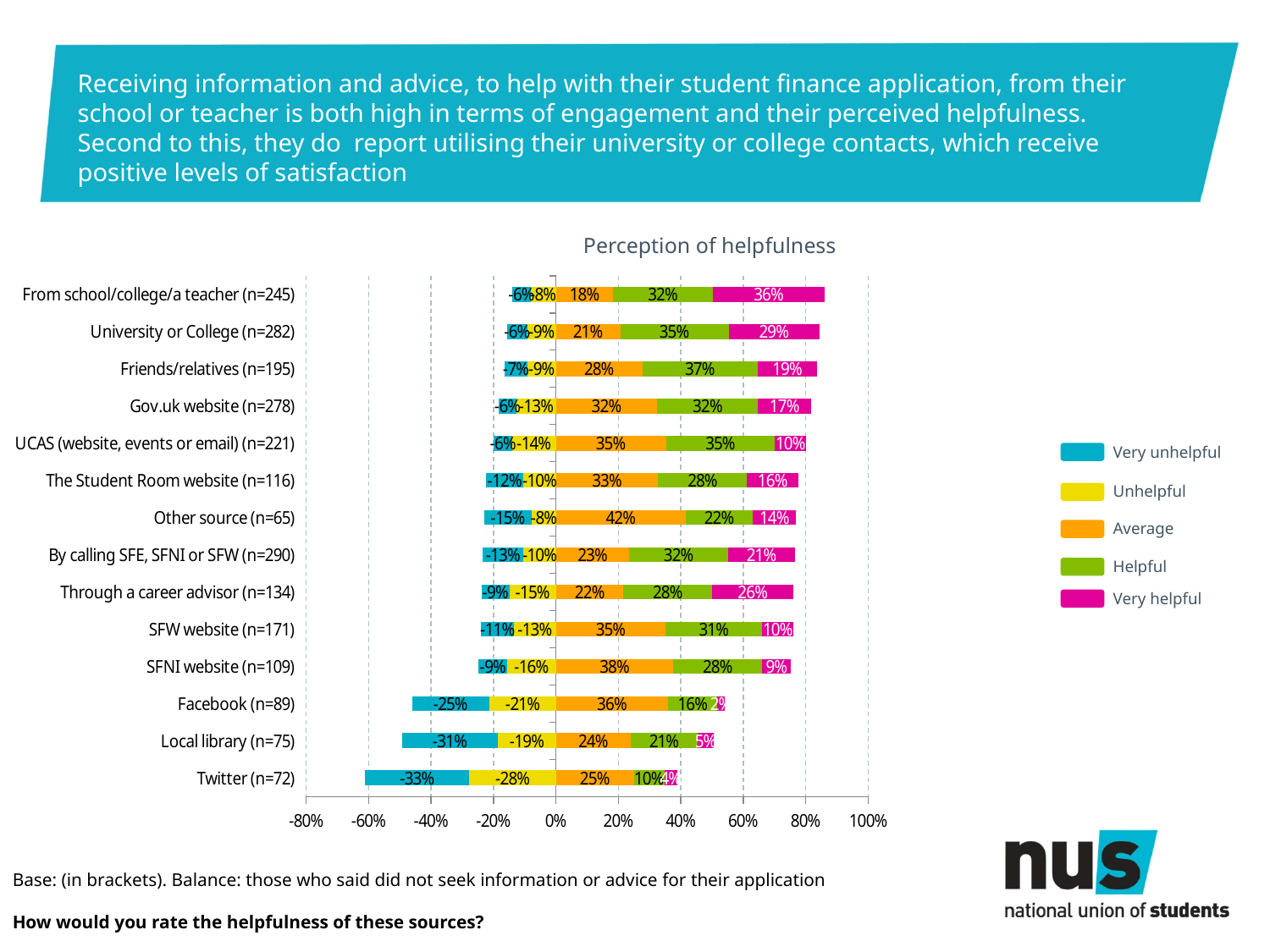
Which has a larger 'Average' value: SFNI website (n=109) or Facebook (n=89)? SFNI website (n=109) What is the title of the chart? Perception of helpfulness What is the 'Very helpful' value for From school/college/a teacher (n=245)? 36% Which source has the largest 'Very unhelpful' share? Twitter (n=72) How many series does the legend list? 5 What is the 'Very unhelpful' value for Local library (n=75)? -31% What type of chart is shown on the slide? bar chart What is the 'Average' value for Other source (n=65)? 42% What is the 'Helpful' value for Friends/relatives (n=195)? 37% Which source has the highest 'Very helpful' value? From school/college/a teacher (n=245) What is the difference between the 'Very helpful' values for University or College (n=282) and Friends/relatives (n=195)? 10% How many sources (categories) are listed on the chart? 14